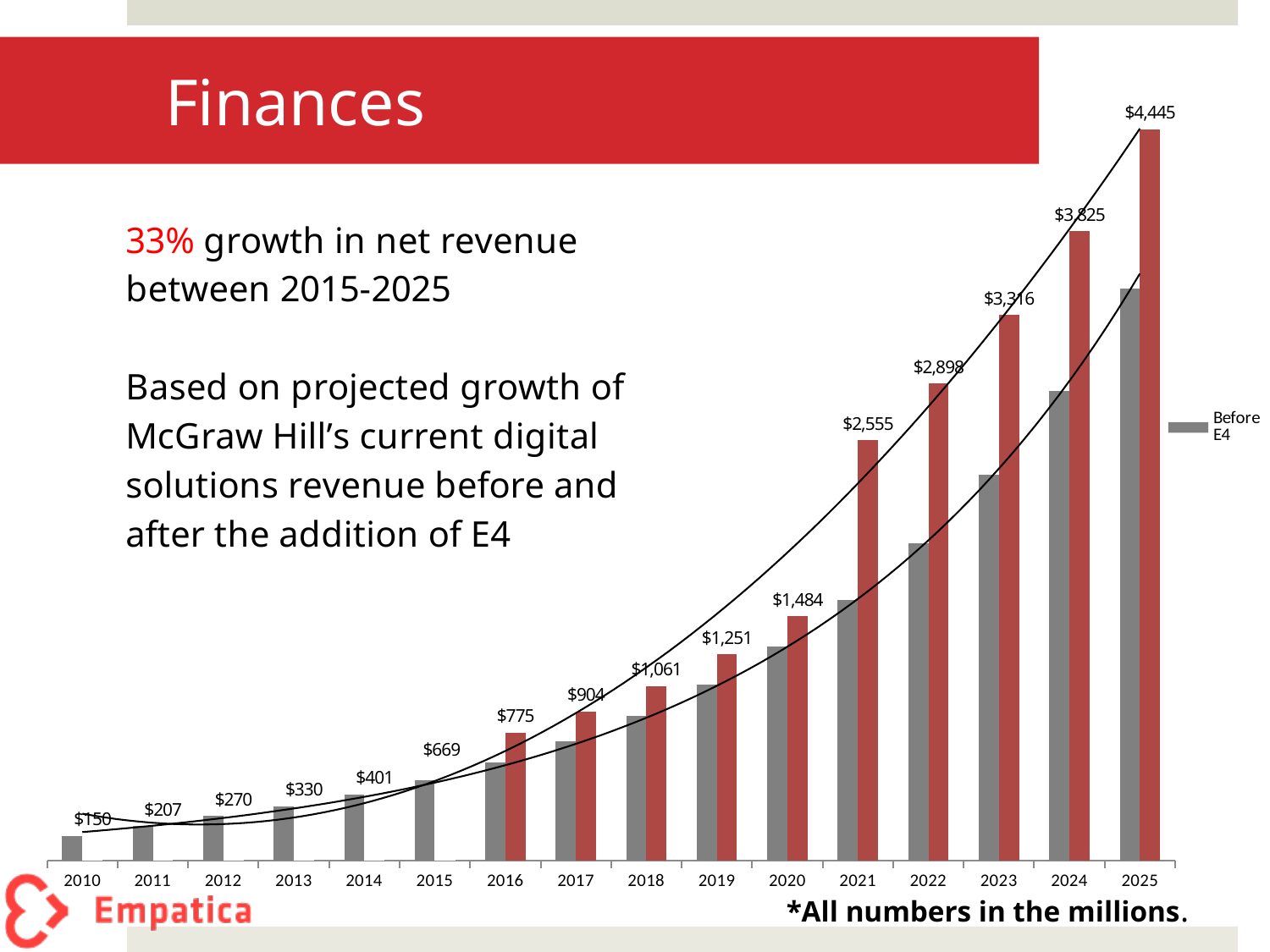
What value is labelled for 2015? $669 What value is labelled for 2010? $150 What is the difference between the labelled values for 2015 and 2014? $268 How many years are shown on the x axis? 16 Which year has the highest labelled value? 2025 What value is labelled for 2020? $1,484 Do the values rise or fall from 2010 to 2025? rise Which is larger, the labelled value for 2021 or for 2020? 2021 Which year has the lowest labelled value? 2010 What is the difference between the labelled values for 2025 and 2024? $620 What value is labelled for 2025? $4,445 What kind of chart is shown on the slide? bar chart